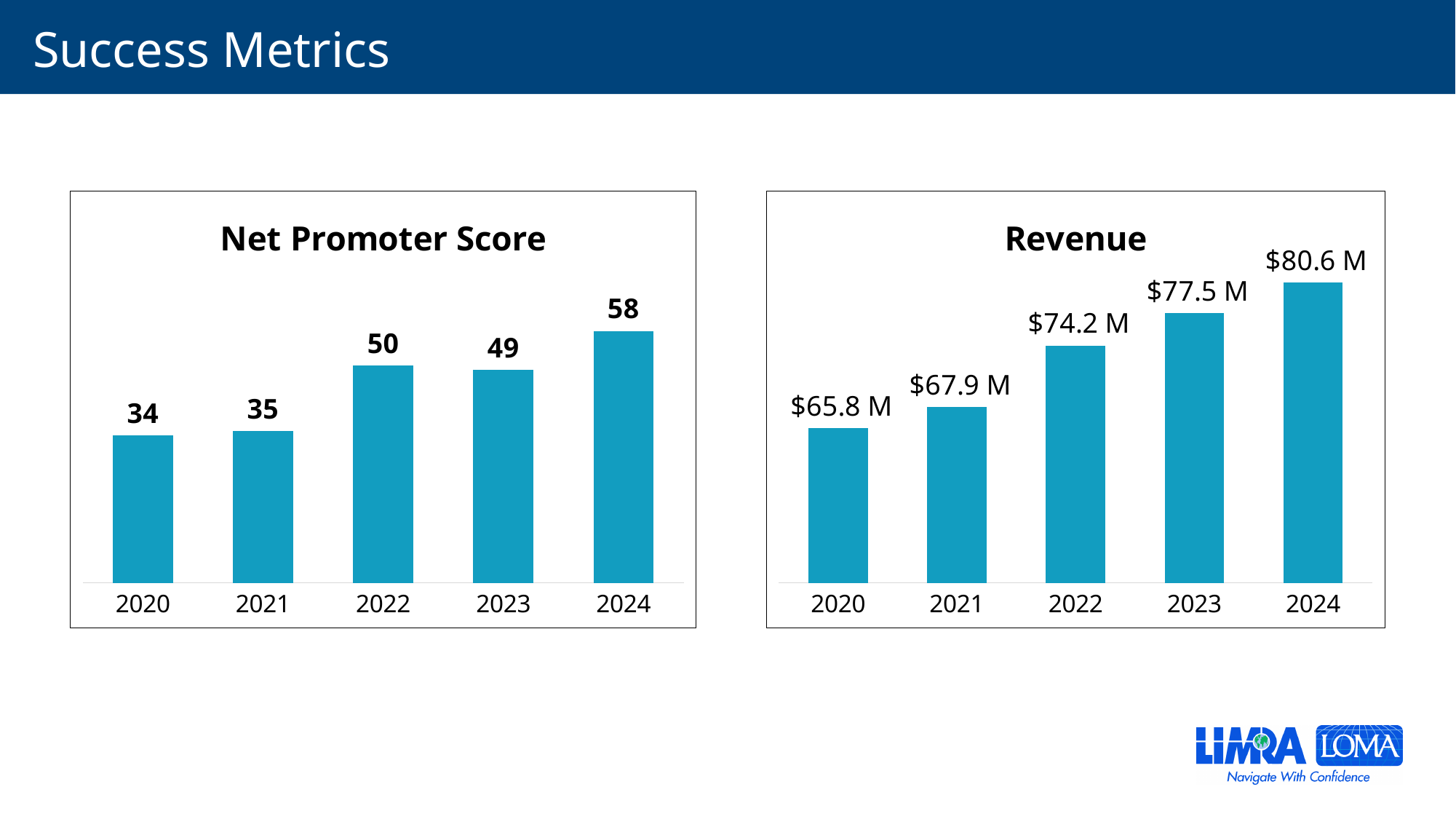
What kind of chart is the Revenue chart? bar chart In the Net Promoter Score chart, which is larger, the value for 2022 or 2023? 2022 In the Net Promoter Score chart, what is the value for 2022? 50 In the Revenue chart, what is the difference between the 2022 and 2021 values? $6.3 M In the Net Promoter Score chart, what is the difference between the 2024 and 2020 values? 24 In the Net Promoter Score chart, how many years are shown? 5 In the Revenue chart, what is the value for 2020? $65.8 M In the Revenue chart, what is the value for 2023? $77.5 M In the Net Promoter Score chart, which year has the highest score? 2024 In the Revenue chart, do the values rise or fall from 2020 to 2024? rise In the Revenue chart, which year has the highest revenue? 2024 In the Net Promoter Score chart, which year has the lowest score? 2020